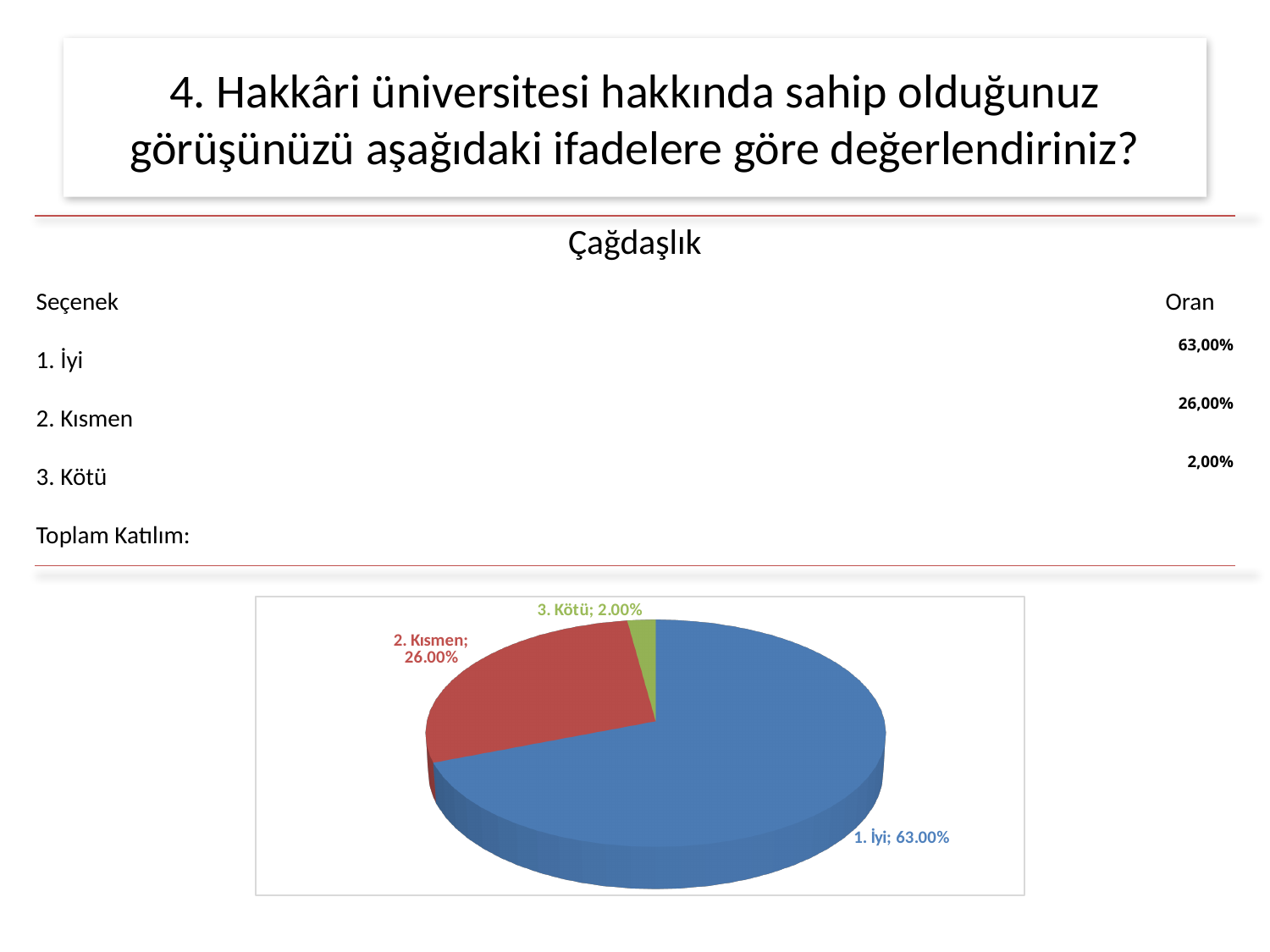
What colour is the slice for "2. Kısmen" in the pie chart? red Which slice of the pie chart is the largest? 1. İyi Which slice of the pie chart is the smallest? 3. Kötü What is the difference between the values for "2. Kısmen" and "3. Kötü" in the pie chart? 24.00% What is the difference between the values for "1. İyi" and "2. Kısmen" in the pie chart? 37.00% How many slices does the pie chart have? 3 What kind of chart is shown on the slide? pie chart What is the value shown for the slice "1. İyi" in the pie chart? 63.00% Which is larger in the pie chart, "2. Kısmen" or "3. Kötü"? 2. Kısmen What is the value shown for the slice "2. Kısmen" in the pie chart? 26.00% What is the value shown for the slice "3. Kötü" in the pie chart? 2.00% What colour is the slice for "1. İyi" in the pie chart? blue